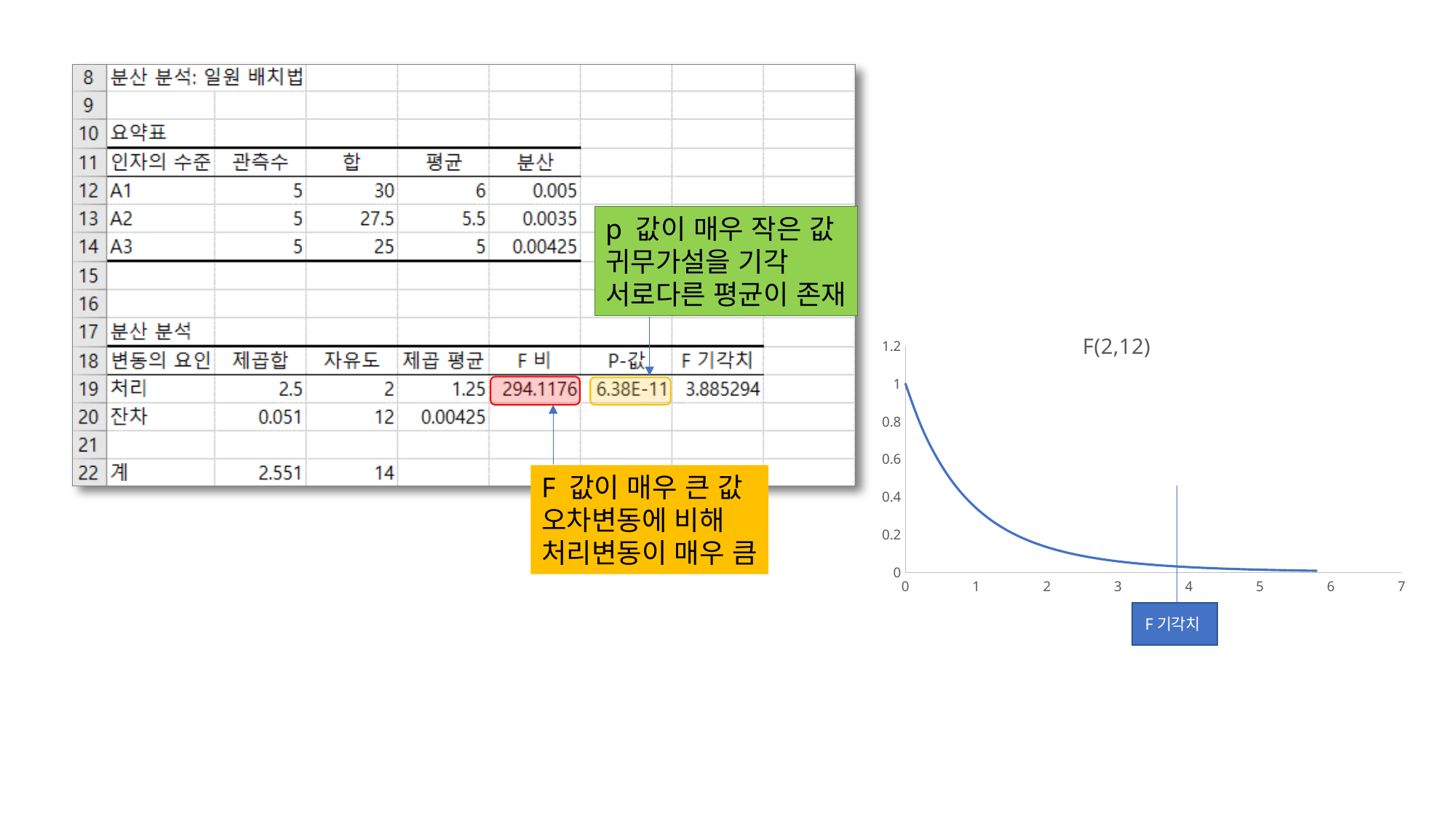
In the F(2,12) chart, which is larger: the value of the curve at x = 1 or at x = 3? x = 1 In the F(2,12) chart, what is the highest tick value shown on the y axis? 1.2 In the F(2,12) chart, is the vertical F 기각치 line located at an x value greater or less than 3? greater In the F(2,12) chart, is the value of the curve at x = 0.5 greater or less than 0.4? greater In the F(2,12) chart, what label is attached to the vertical line crossing the curve? F 기각치 In the F(2,12) chart, does the curve rise or fall as x increases? fall In the F(2,12) chart, what is the value of the curve at x = 0? 1 In the F(2,12) chart, is the value of the curve at x = 3 greater or less than 0.2? less What kind of chart is shown on the right side of the slide? line chart In the F(2,12) chart, at which x value is the curve highest? 0 What is the title of the chart on the right side of the slide? F(2,12)